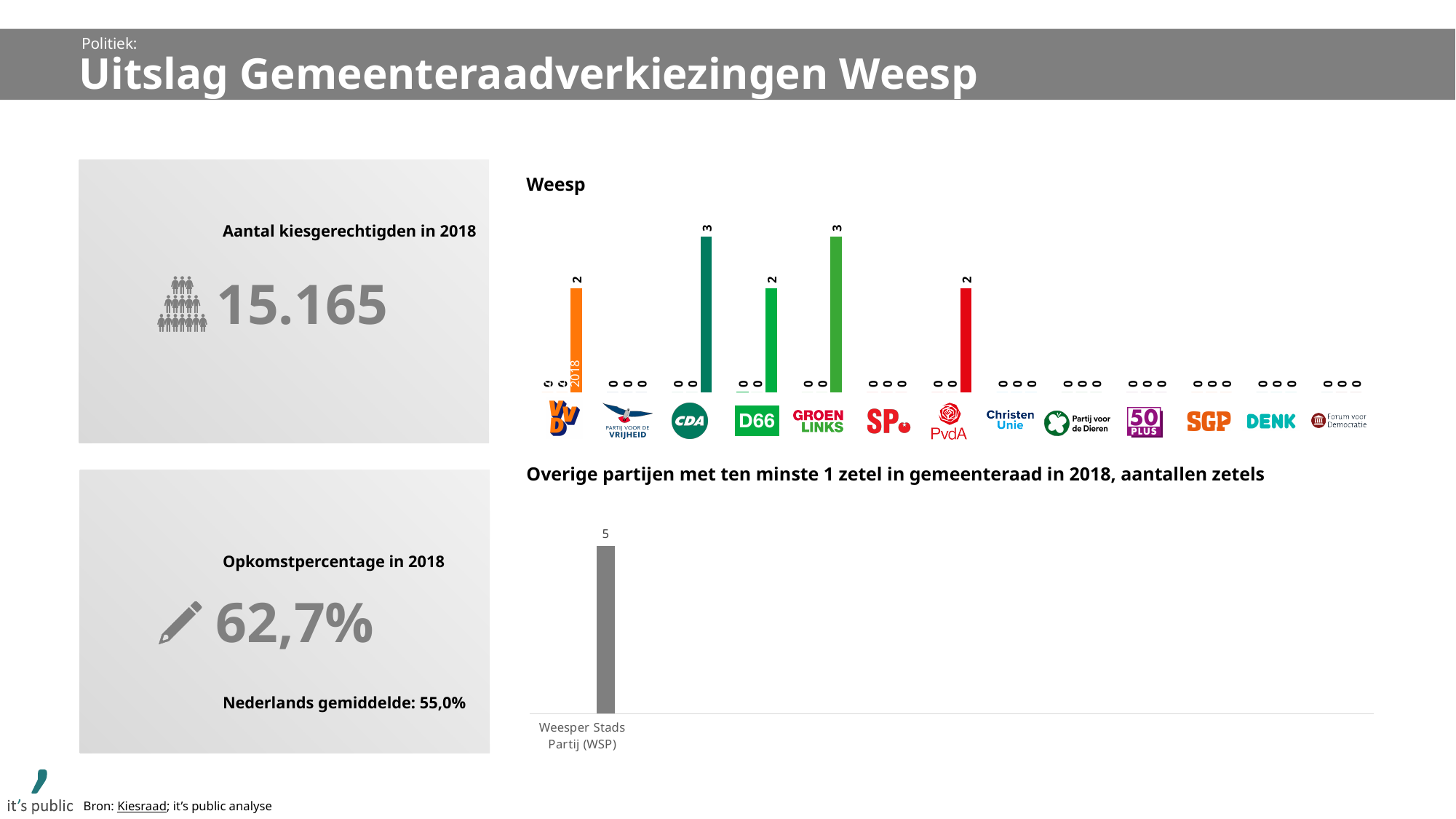
In the 'Weesp' chart, what is the difference in 2018 seats between GroenLinks and VVD? 1 In the 'Weesp' chart, how many seats does CDA have in 2018? 3 In the 'Weesp' chart, how many seats does PvdA have in 2018? 2 In the 'Weesp' chart, how many seats does GroenLinks have in 2018? 3 In the 'Weesp' chart, how many seats does VVD have in 2018? 2 What kind of chart is the 'Overige partijen met ten minste 1 zetel in gemeenteraad in 2018, aantallen zetels' chart? bar chart In the chart 'Overige partijen met ten minste 1 zetel in gemeenteraad in 2018, aantallen zetels', how many seats does Weesper Stads Partij (WSP) have? 5 In the 'Weesp' chart, how many seats does SP have in 2018? 0 In the 'Weesp' chart, which has more seats in 2018, CDA or D66? CDA In the 'Weesp' chart, how many parties are shown along the x axis? 13 How many parties are shown in the chart 'Overige partijen met ten minste 1 zetel in gemeenteraad in 2018, aantallen zetels'? 1 In the 'Weesp' chart, how many seats does D66 have in 2018? 2